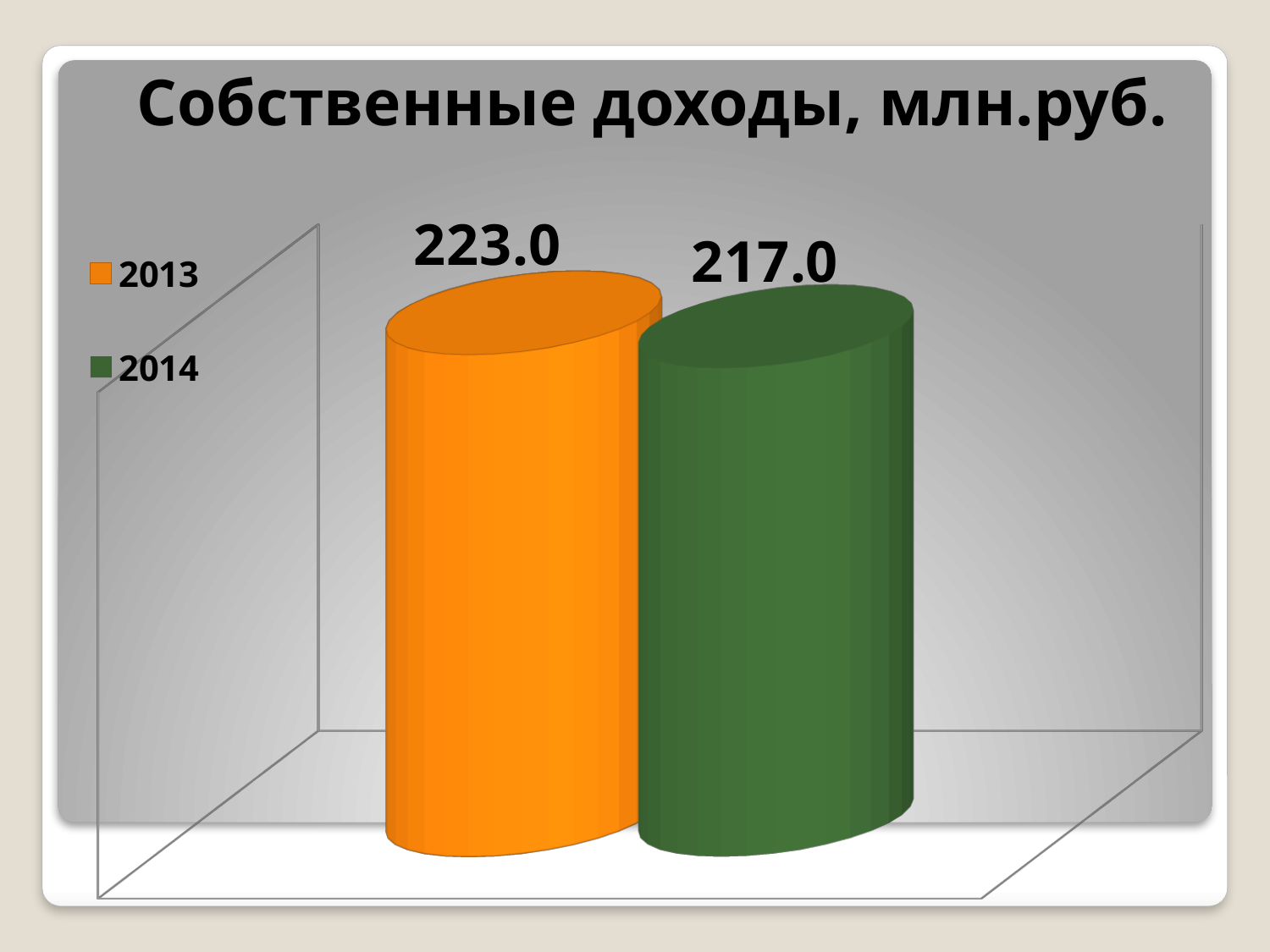
What is the value for 2014? 217.0 Do the values rise or fall from 2013 to 2014? fall What is the title of the chart? Собственные доходы, млн.руб. Which year has the higher value? 2013 Which year has the lower value? 2014 How many series does the legend list? 2 What colour is the bar for 2014? green What is the value for 2013? 223.0 Is the value for 2013 larger or smaller than the value for 2014? larger What kind of chart is shown? bar chart What is the difference between the 2013 and 2014 values? 6.0